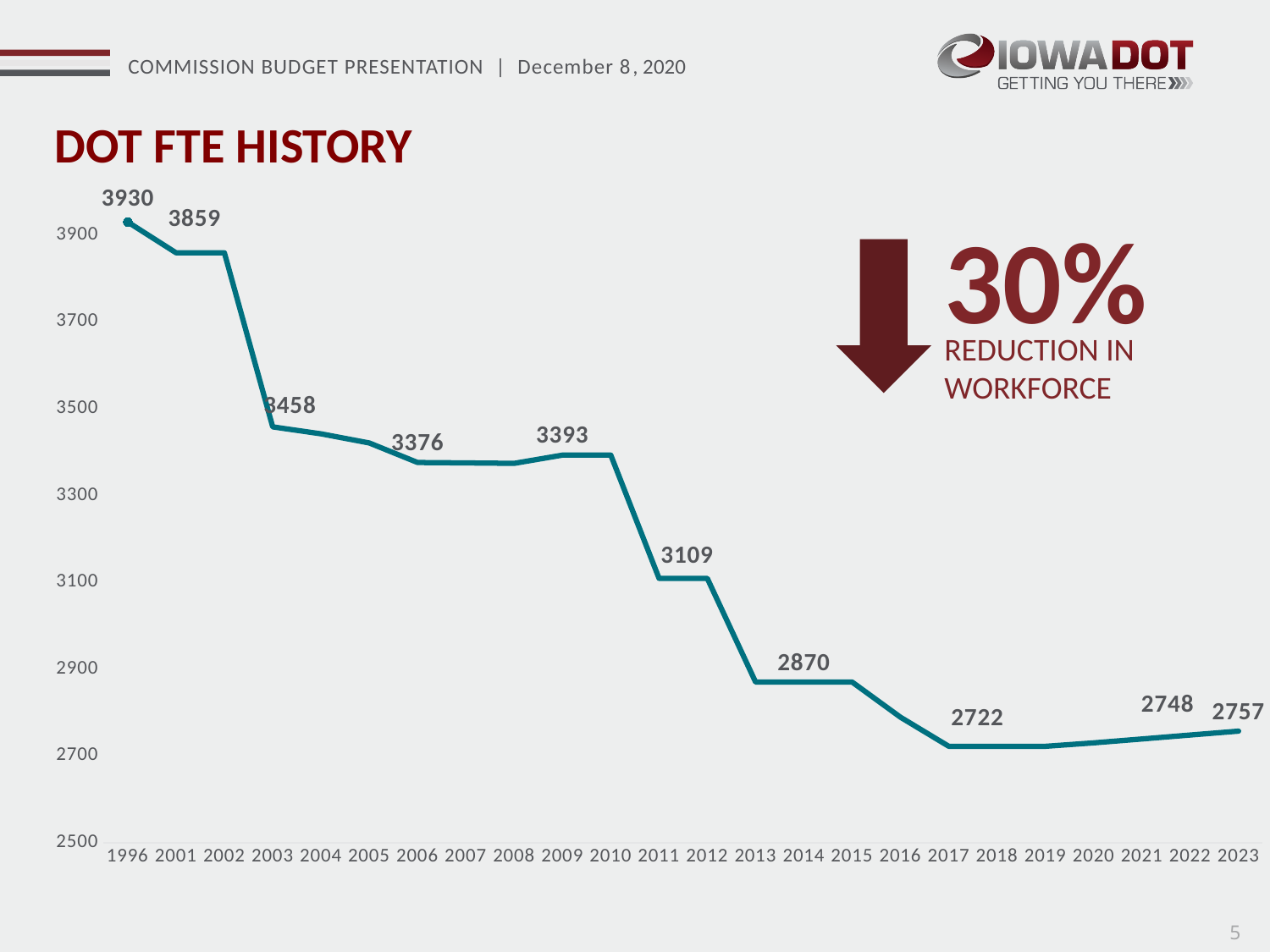
What is the lowest value labeled on the chart? 2722 What is the FTE value for 2023? 2757 How many years are shown on the x axis? 24 What is the FTE value for 2003? 3458 What kind of chart is shown on the slide? line chart Which is larger, the FTE value for 1996 or the FTE value for 2023? 1996 What is the title of the chart? DOT FTE HISTORY Which year has the highest FTE value? 1996 Do the values generally rise or fall from 1996 to 2023? fall What is the FTE value for 1996? 3930 What is the difference between the FTE value for 1996 and the FTE value for 2023? 1173 Is the value for 2015 greater or less than 2900? less